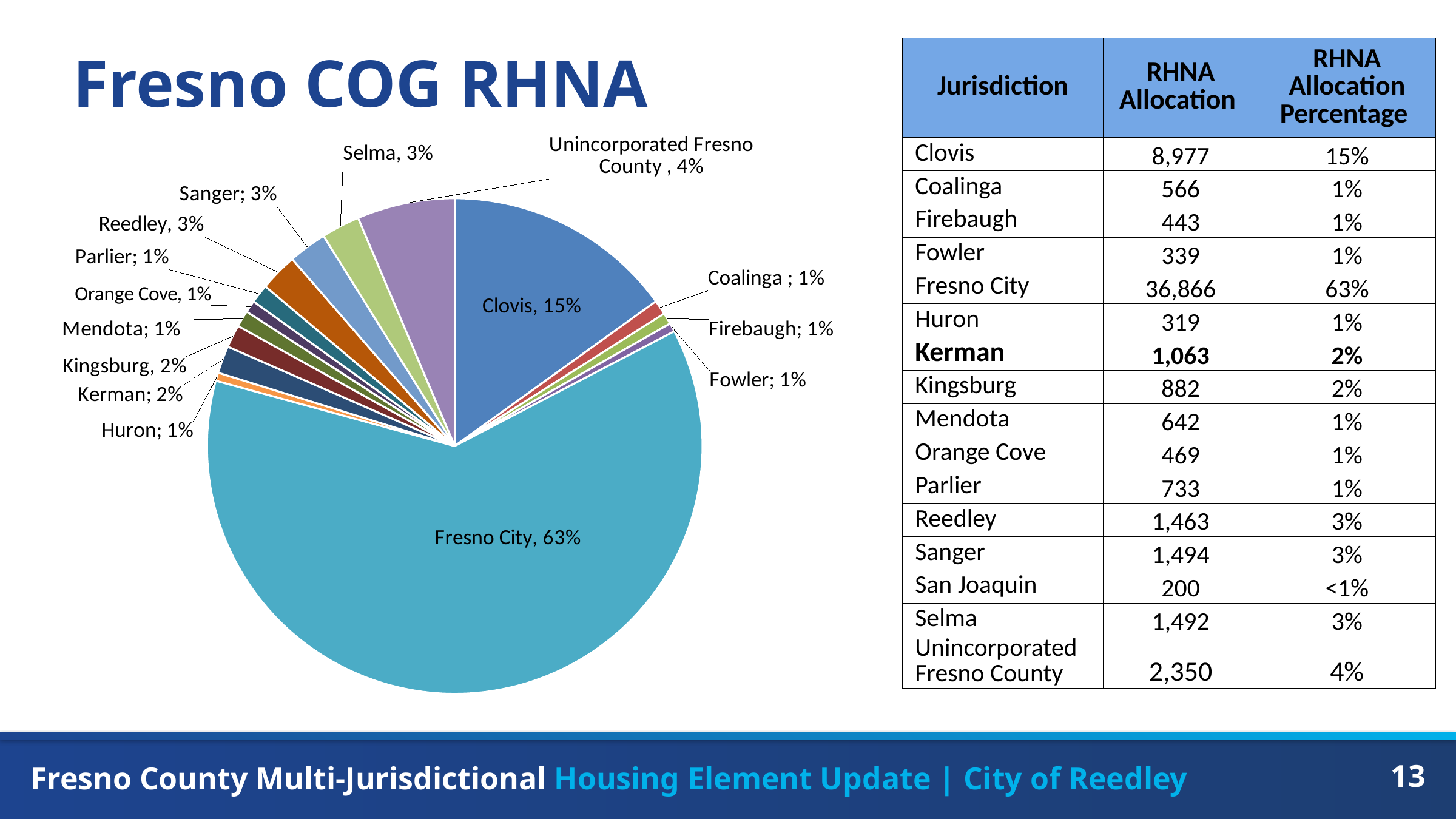
What percentage is shown for Kerman in the pie chart? 2% What type of chart is shown on the slide? pie chart What percentage is shown for Selma in the pie chart? 3% Which has a larger slice in the pie chart, Clovis or Unincorporated Fresno County? Clovis What share of the pie does Clovis hold? 15% What is the title of the slide containing the chart? Fresno COG RHNA Which jurisdiction has the largest slice of the pie chart? Fresno City Which has a larger slice in the pie chart, Reedley or Kingsburg? Reedley What is the difference in percentage points between Fresno City and Clovis in the pie chart? 48 What percentage is shown for Mendota in the pie chart? 1% What percentage is shown for Unincorporated Fresno County in the pie chart? 4% What share of the pie does Fresno City hold? 63%